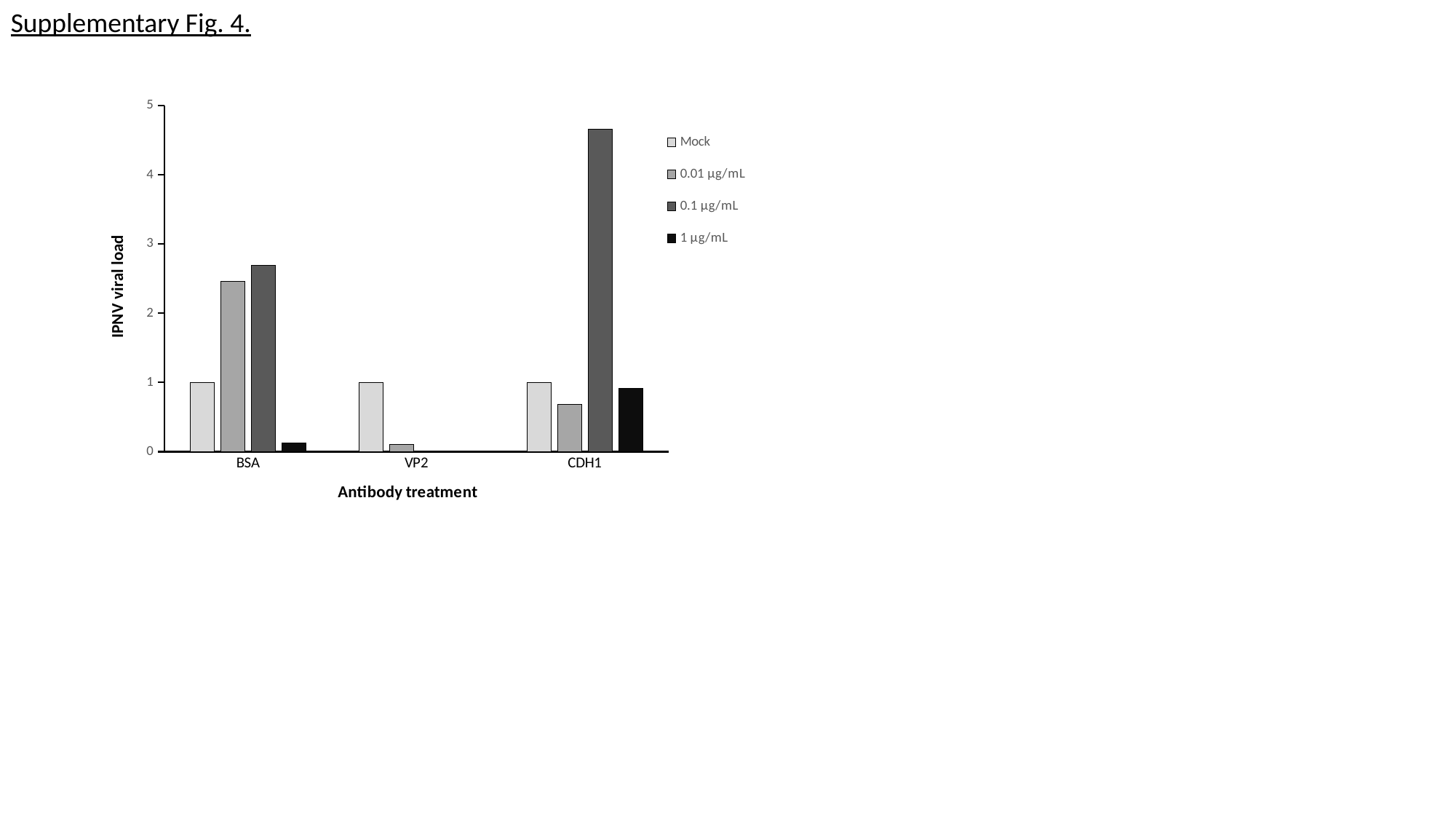
Which antibody treatment has the highest value for the 0.1 µg/mL series? CDH1 Is the value for 1 µg/mL at BSA greater or less than 1? less What is the label of the x axis? Antibody treatment How many antibody treatment categories are shown on the x axis? 3 What kind of chart is shown on the slide? bar chart What is the label of the y axis? IPNV viral load What is the IPNV viral load for the Mock series at BSA? 1 Is the value for 0.01 µg/mL at VP2 greater or less than 1? less Which is larger: the 0.01 µg/mL value at BSA or the 0.01 µg/mL value at CDH1? BSA Is the value for 0.1 µg/mL at CDH1 greater or less than 4? greater How many series does the legend list? 4